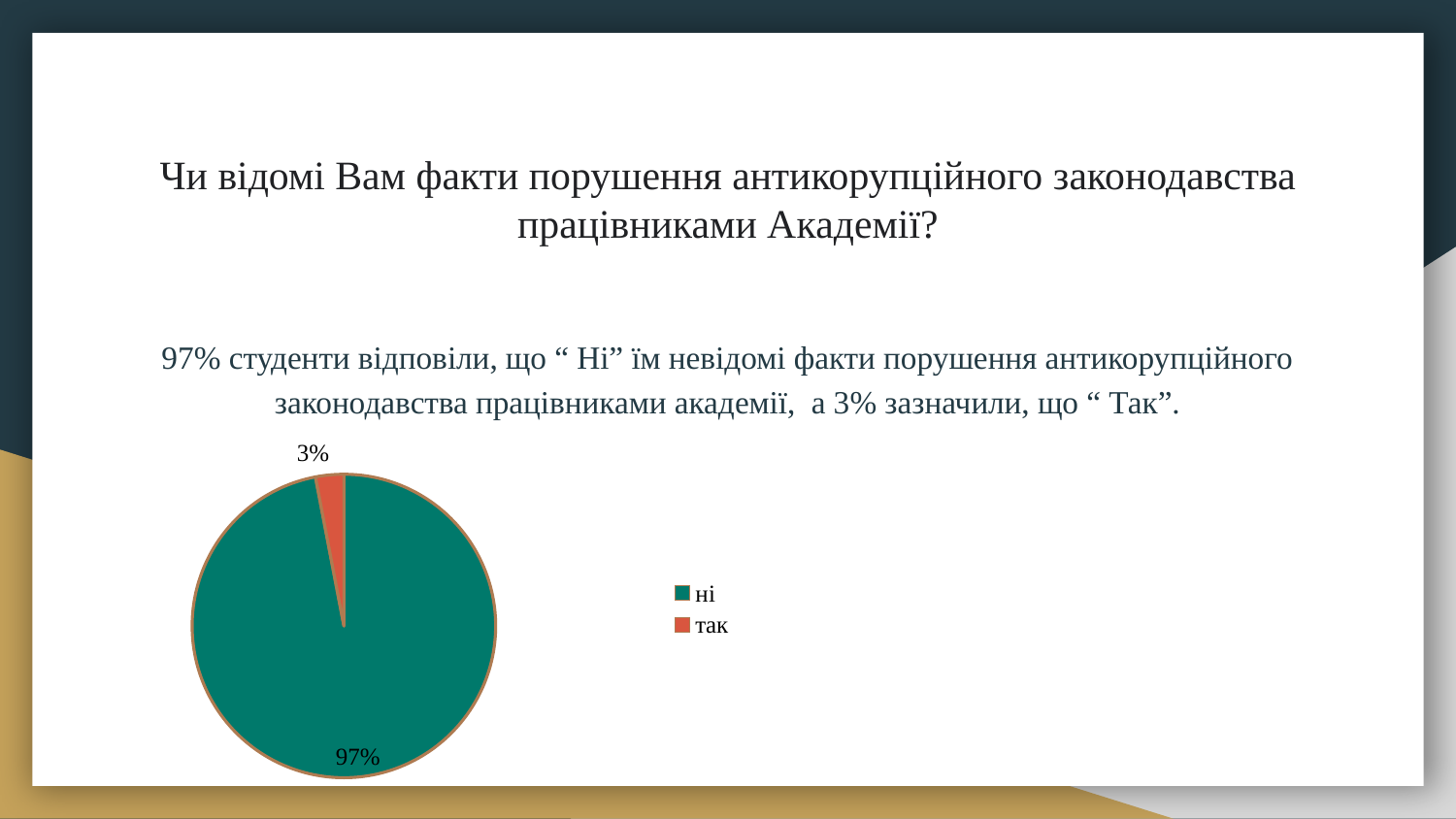
What share of the pie does the "так" slice represent? 3% What share of the pie does the "ні" slice represent? 97% What is the difference in percentage points between the "ні" and "так" slices? 94 How many slices does the pie chart have? 2 What kind of chart is shown on the slide? pie chart Which slice of the pie is the smallest? так What colour is the "ні" slice in the pie chart? teal green How many entries does the legend list? 2 Which is larger, the "ні" slice or the "так" slice? ні Which slice of the pie is the largest? ні What colour is the "так" slice in the pie chart? orange-red